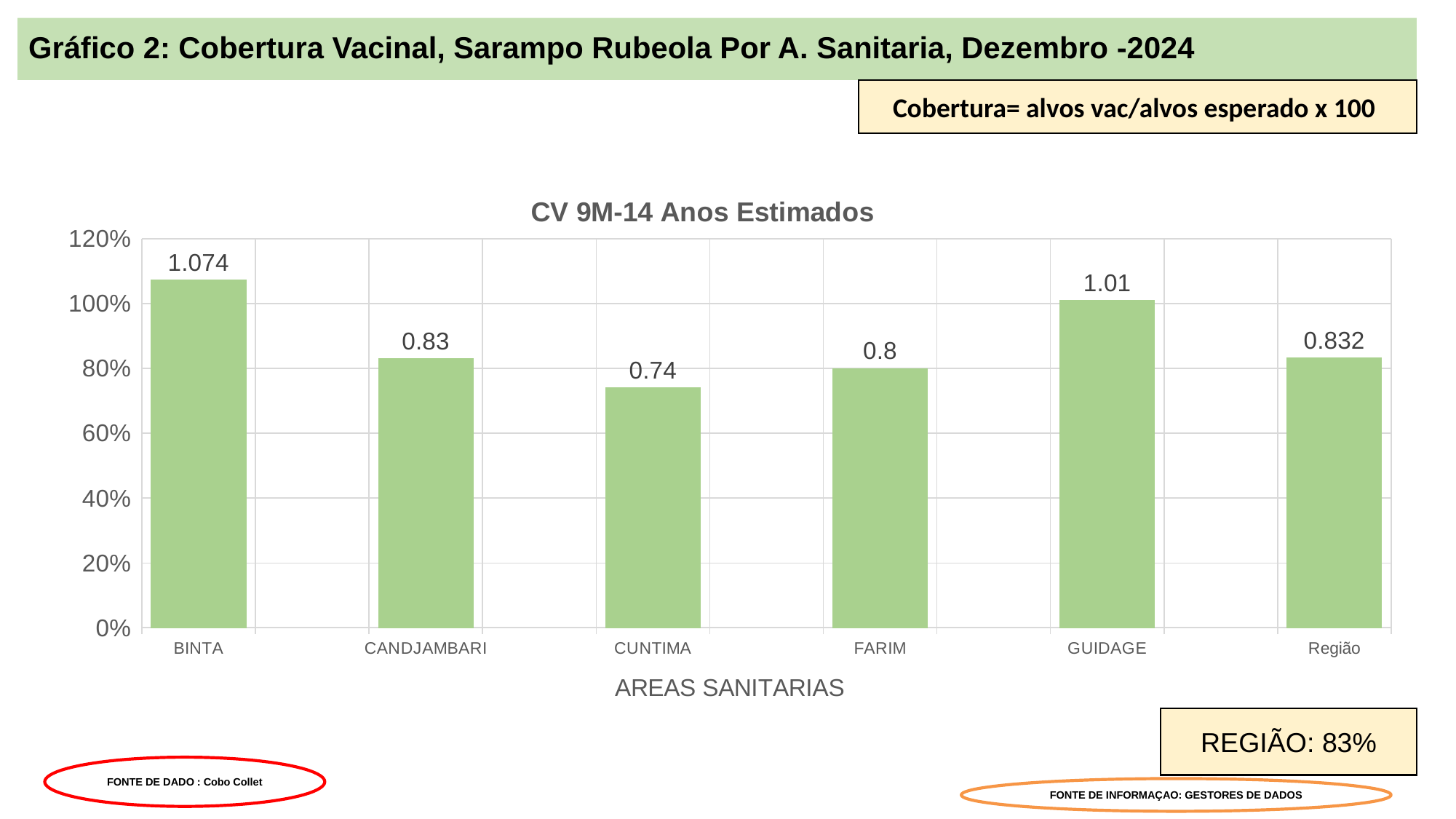
Which is larger, the value for FARIM or the value for GUIDAGE? GUIDAGE What is the difference between the values for BINTA and CUNTIMA? 0.334 How many areas are shown on the x axis? 6 What is the value shown for Região? 0.832 What is the difference between the values for GUIDAGE and FARIM? 0.21 Is the value for CUNTIMA greater or less than 80%? less Which area has the lowest value? CUNTIMA Which area has the highest value? BINTA What is the value shown for CUNTIMA? 0.74 What is the value shown for BINTA? 1.074 What is the value shown for GUIDAGE? 1.01 What kind of chart is this? bar chart